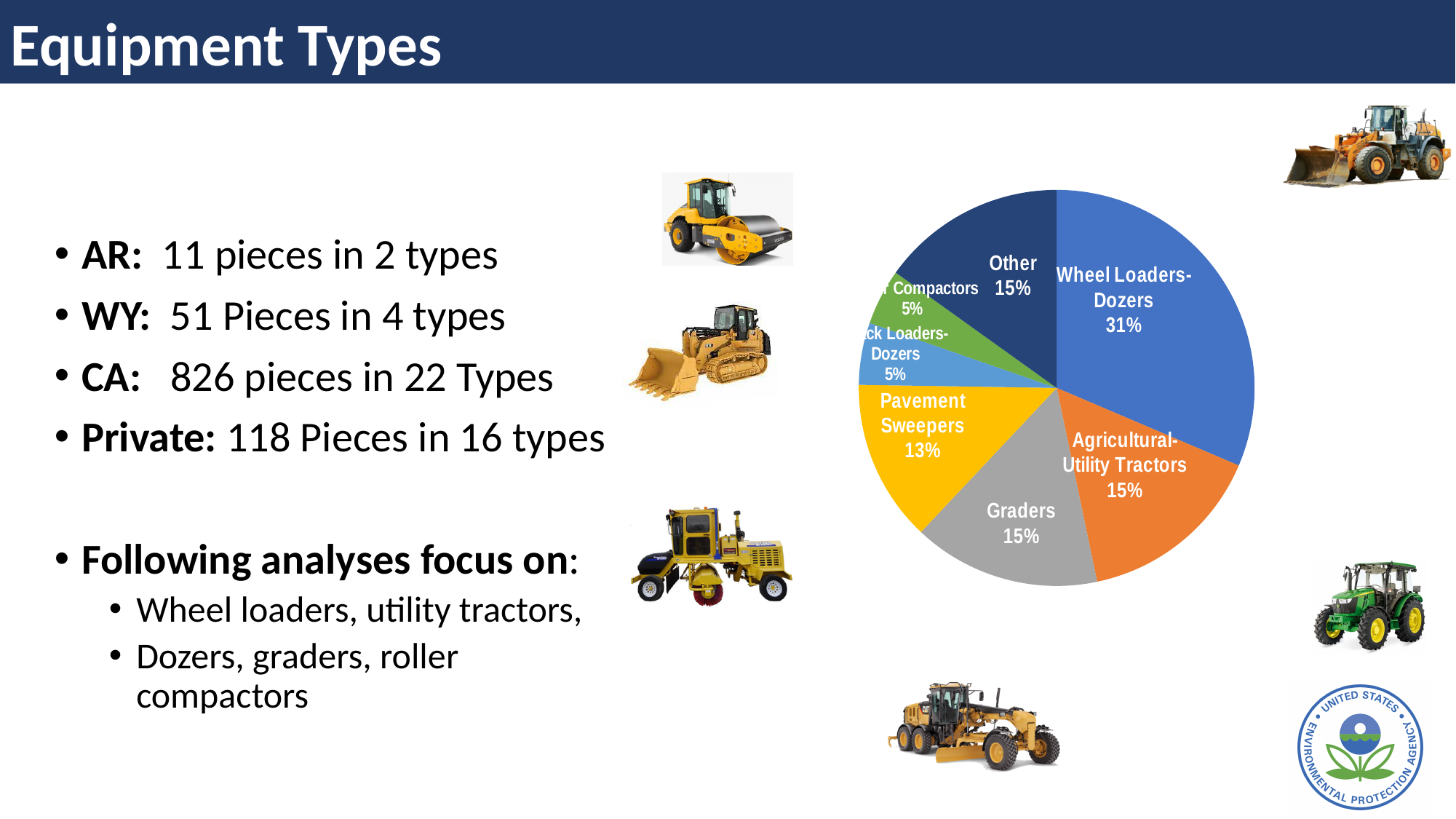
How many percentage points larger is the Wheel Loaders-Dozers slice than the Pavement Sweepers slice? 18% What colour is the Wheel Loaders-Dozers slice? blue What share of the pie is Agricultural-Utility Tractors? 15% What share of the pie is labelled Other? 15% What share of the pie is Graders? 15% What kind of chart is shown on the slide? pie chart Which slice is larger, Graders or Pavement Sweepers? Graders How many slices does the pie chart have? 7 What share of the pie is Pavement Sweepers? 13% How many percentage points larger is the Wheel Loaders-Dozers slice than the Graders slice? 16% Which slice of the pie chart is the largest? Wheel Loaders-Dozers What share of the pie is Wheel Loaders-Dozers? 31%